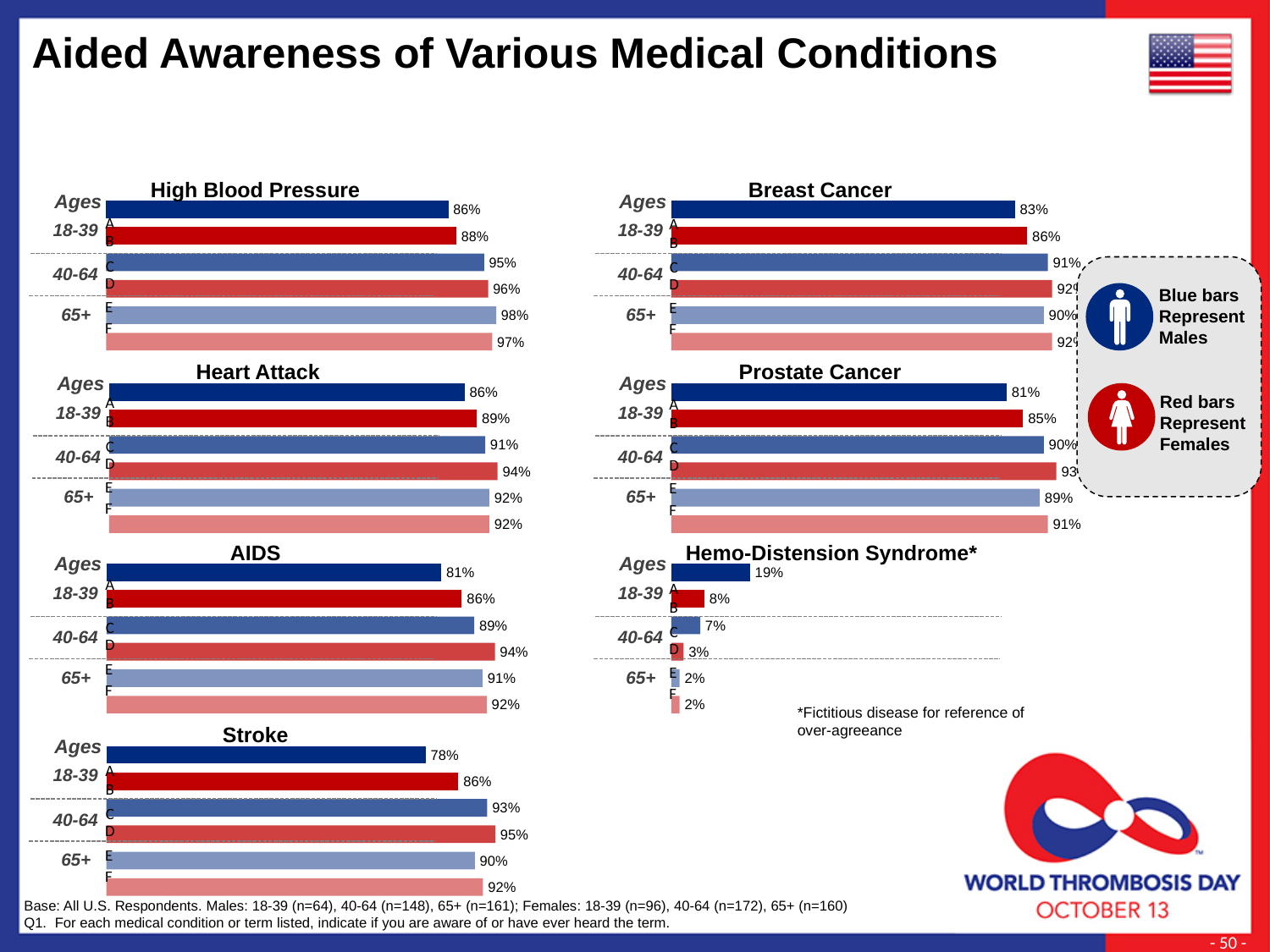
In the Hemo-Distension Syndrome chart, what is the value for males aged 18-39? 19% In the Stroke chart, which age/gender group has the highest value? Females 40-64 In the Prostate Cancer chart, which is larger: males aged 18-39 or females aged 18-39? Females 18-39 What type of chart is used for each medical condition on this slide? Bar chart In the Heart Attack chart, which age/gender group has the lowest value? Males 18-39 In the AIDS chart, what is the value for females aged 40-64? 94% According to the legend on the slide, what do the blue bars represent? Males In the Stroke chart, what is the difference between females aged 18-39 and males aged 18-39? 8% In the Stroke chart, what is the value for males aged 18-39? 78% In the Hemo-Distension Syndrome chart, what is the difference between males aged 18-39 and females aged 18-39? 11% In the High Blood Pressure chart, what is the value for males aged 65+? 98% In the Breast Cancer chart, what is the value for males aged 18-39? 83%